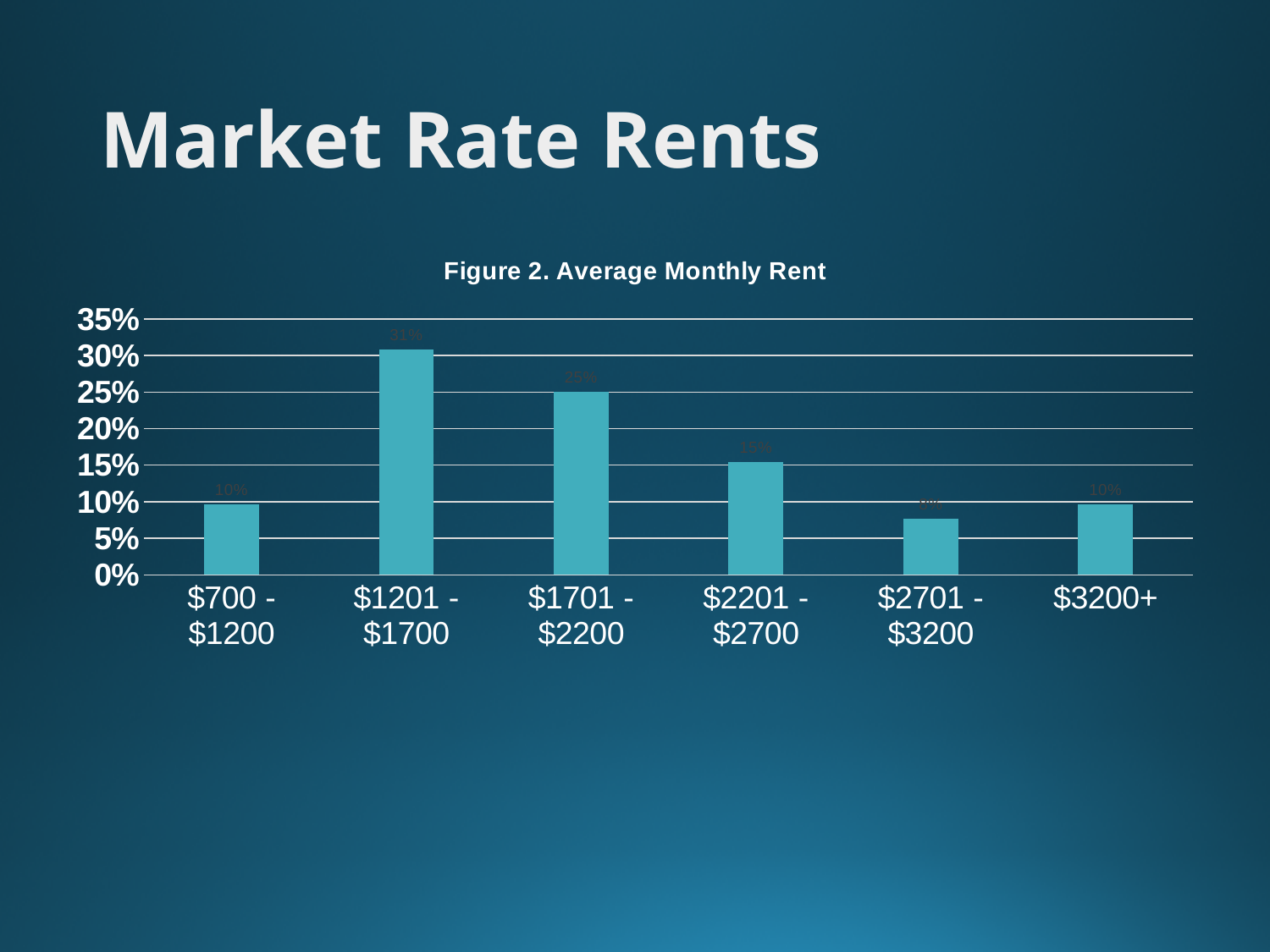
What is the difference between the values for $1201 - $1700 and $1701 - $2200? 6% What is the value for the $2201 - $2700 category? 15% What is the value for the $1701 - $2200 category? 25% Which is larger, the value for $1701 - $2200 or the value for $2201 - $2700? $1701 - $2200 What type of chart is shown on the slide? bar chart Is the value for $2701 - $3200 greater or less than 10%? less Is the value for $1201 - $1700 greater or less than 30%? greater How many rent categories are shown on the x axis? 6 Which rent category has the highest value? $1201 - $1700 Which rent category has the lowest value? $2701 - $3200 What is the value for the $1201 - $1700 category? 31% What is the title of the chart? Figure 2. Average Monthly Rent